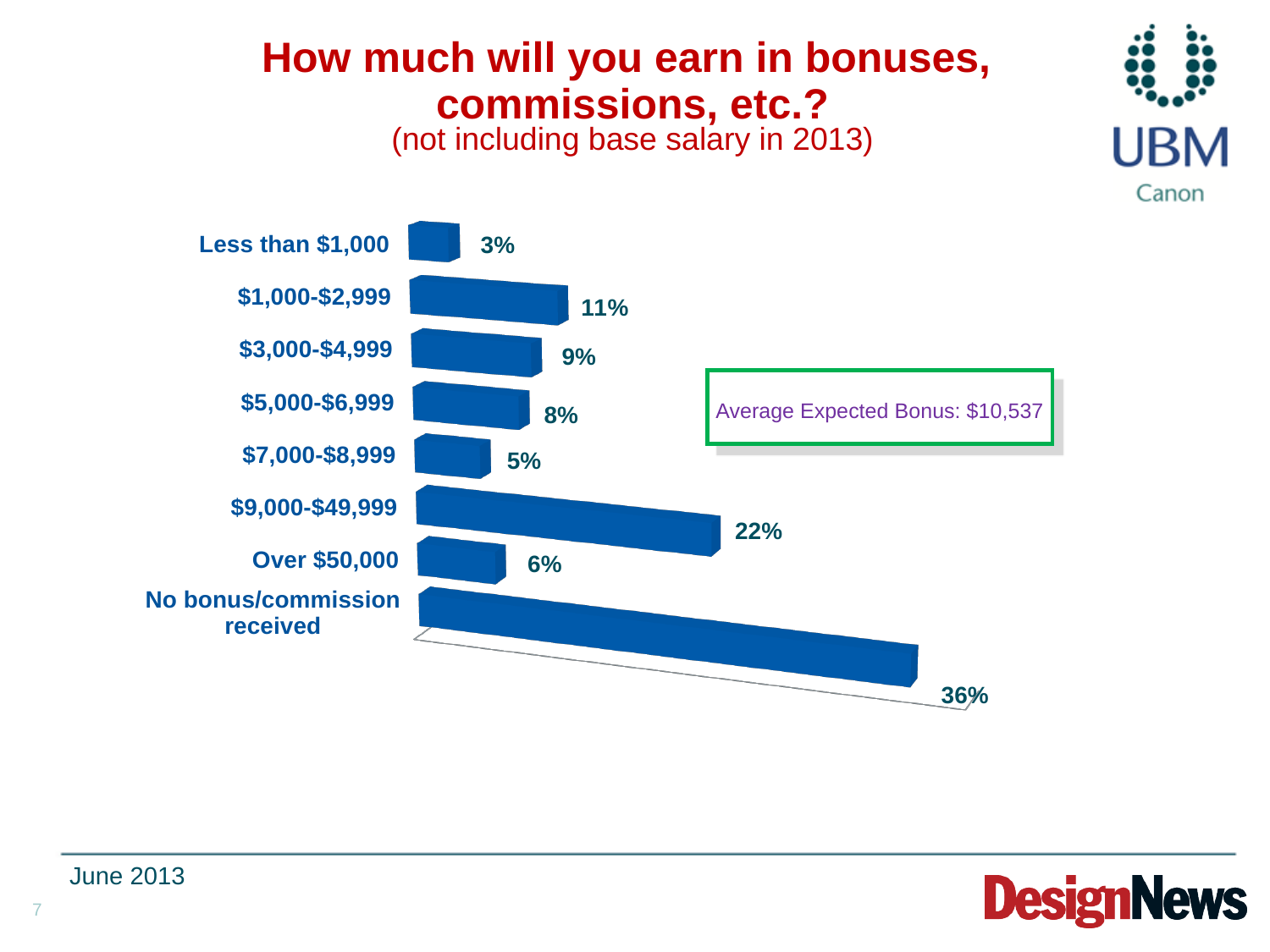
What percentage of respondents expect no bonus/commission received? 36% Which category has the lowest percentage of respondents? Less than $1,000 Which category has a larger share of respondents: $3,000-$4,999 or $5,000-$6,999? $3,000-$4,999 What percentage of respondents expect to earn $9,000-$49,999 in bonuses, commissions, etc.? 22% What is the difference in percentage points between the $7,000-$8,999 category and the Over $50,000 category? 1 What is the difference in percentage points between the $9,000-$49,999 category and the $1,000-$2,999 category? 11 How many categories are shown in the chart? 8 What is the average expected bonus stated on the slide? $10,537 What percentage of respondents expect to earn over $50,000 in bonuses? 6% Which category has the highest percentage of respondents? No bonus/commission received What kind of chart is shown on the slide? Bar chart What percentage of respondents expect to earn less than $1,000 in bonuses? 3%